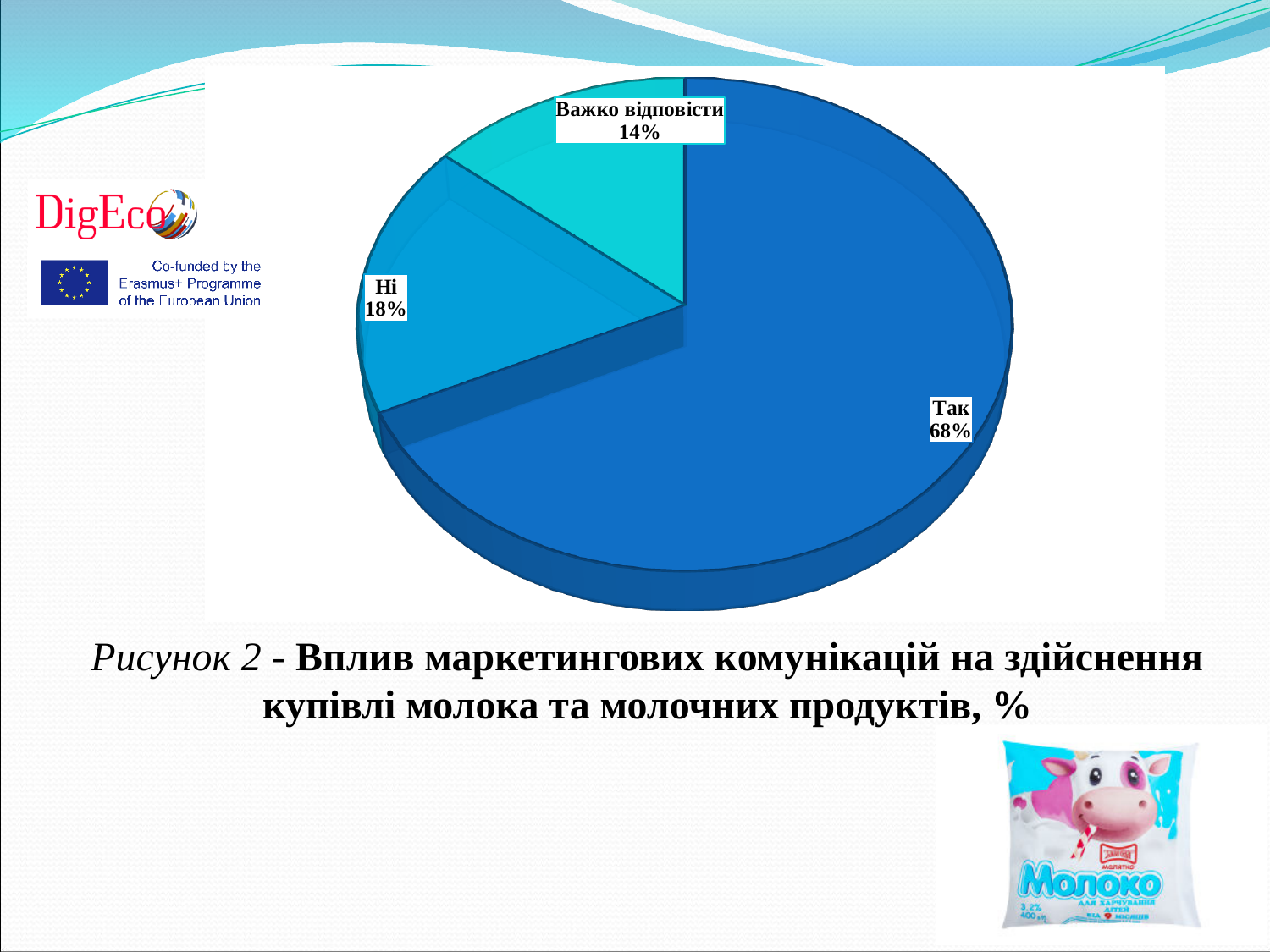
What share of the pie does the "Ні" slice represent? 18% What share of the pie does the "Важко відповісти" slice represent? 14% Which slice of the pie is the smallest? Важко відповісти Which slice of the pie is the largest? Так What kind of chart is shown on the slide? Pie chart How many slices does the pie chart have? 3 What is the combined share of the "Ні" and "Важко відповісти" slices? 32% What is the figure number given in the caption below the chart? Рисунок 2 What is the difference in percentage points between the "Так" and "Ні" slices? 50 What share of the pie does the "Так" slice represent? 68% What is the difference in percentage points between the "Ні" and "Важко відповісти" slices? 4 Which is larger, the "Ні" slice or the "Важко відповісти" slice? Ні